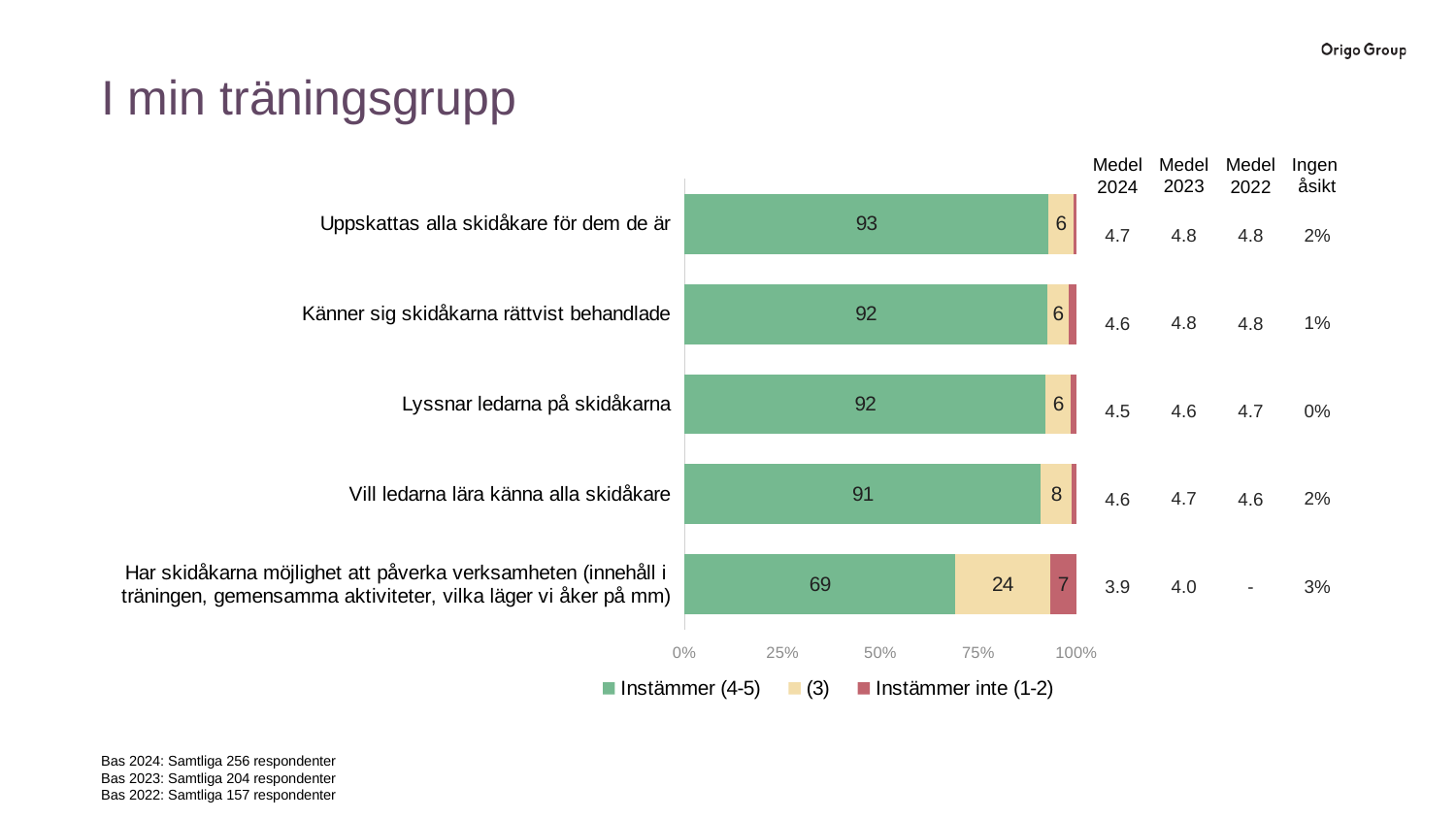
What is the 'Instämmer (4-5)' value for 'Uppskattas alla skidåkare för dem de är'? 93 Is the 'Instämmer (4-5)' value for 'Lyssnar ledarna på skidåkarna' larger or smaller than that for 'Vill ledarna lära känna alla skidåkare'? Larger How many series does the legend list? 3 What is the 'Instämmer inte (1-2)' value for 'Har skidåkarna möjlighet att påverka verksamheten'? 7 What is the 'Instämmer (4-5)' value for 'Har skidåkarna möjlighet att påverka verksamheten (innehåll i träningen, gemensamma aktiviteter, vilka läger vi åker på mm)'? 69 Which statement has the lowest 'Instämmer (4-5)' value? Har skidåkarna möjlighet att påverka verksamheten (innehåll i träningen, gemensamma aktiviteter, vilka läger vi åker på mm) How many categories (statements) are plotted in the chart? 5 What is the difference between the 'Instämmer (4-5)' values for 'Uppskattas alla skidåkare för dem de är' and 'Har skidåkarna möjlighet att påverka verksamheten'? 24 What is the '(3)' value for 'Vill ledarna lära känna alla skidåkare'? 8 Which statement has the highest 'Instämmer (4-5)' value? Uppskattas alla skidåkare för dem de är What is the title of the chart on the slide? I min träningsgrupp What kind of chart is shown on the slide? Stacked bar chart